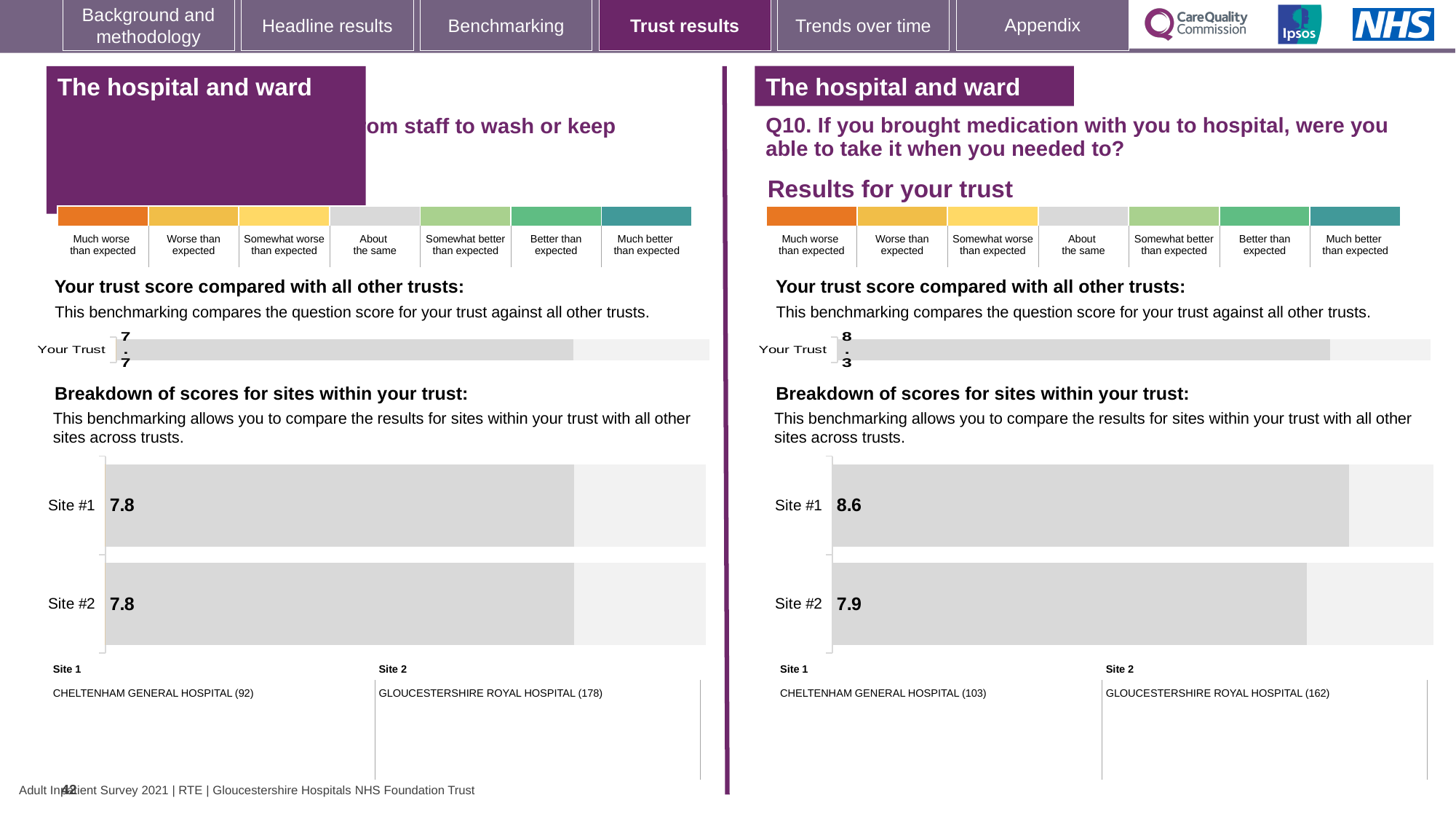
On the left-hand 'Your trust score compared with all other trusts' chart, what is the score shown for Your Trust? 7.7 On the right-hand side of the slide, which hospital is listed as Site 2? GLOUCESTERSHIRE ROYAL HOSPITAL (162) How many sites are shown in the right-hand site breakdown chart for Q10? 2 On the right-hand site breakdown chart for Q10, what is the difference between the Site #1 and Site #2 scores? 0.7 On the left-hand site breakdown chart, what is the score for Site #2? 7.8 On the right-hand 'Your trust score compared with all other trusts' chart for Q10, what is the score shown for Your Trust? 8.3 What type of chart is used for the site breakdown on the right-hand side of the slide? Bar chart On the right-hand chart for Q10 (medication), what is the score for Site #2? 7.9 On the right-hand site breakdown chart for Q10, which site has the higher score? Site #1 On the right-hand chart for Q10 (medication), what is the score for Site #1? 8.6 On the left-hand site breakdown chart, what is the score for Site #1? 7.8 On the right-hand site breakdown chart for Q10, is the score for Site #1 larger than the score for Site #2? Yes